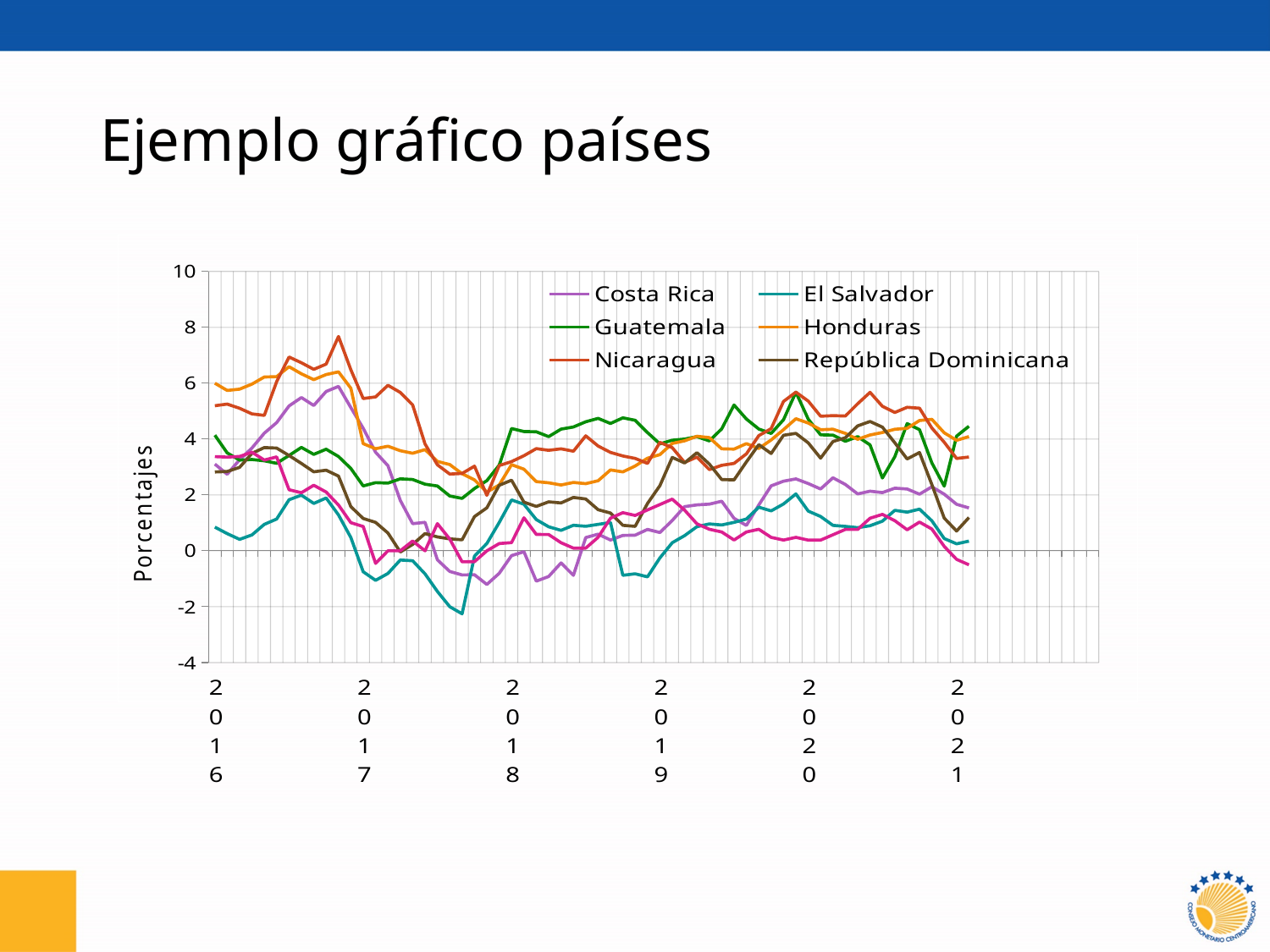
Which series reaches the lowest value anywhere on the chart? El Salvador Is the value for Honduras at the start of 2016 greater or less than 4? greater At the start of 2016, which is larger, the value for Honduras or the value for El Salvador? Honduras Which series reaches the highest value anywhere on the chart? Nicaragua What is the label on the vertical axis of the chart? Porcentajes What kind of chart is shown on the slide? line chart Which country is plotted with the green line? Guatemala Is the lowest value of El Salvador in 2018 greater or less than 0? less How many year labels appear along the x axis? 6 Does the El Salvador line rise or fall from the end of 2017 to the start of 2018? rise How many series does the legend list? 6